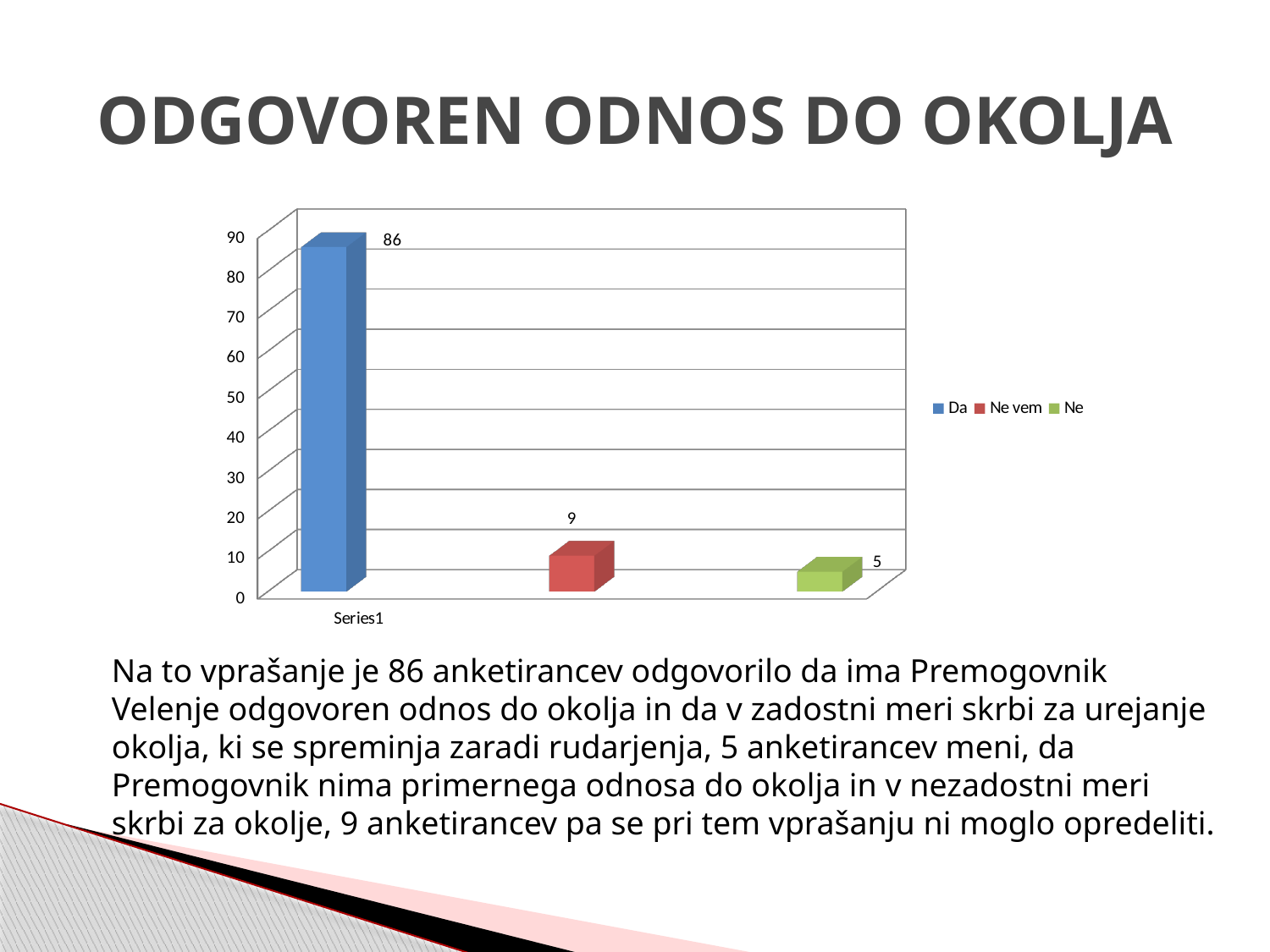
How many series does the legend list? 3 What is the value for "Da"? 86 What is the difference between the values for "Ne vem" and "Ne"? 4 Which legend entry has the highest value? Da Which legend entry has the lowest value? Ne What colour is the bar for "Ne"? green What kind of chart is shown on the slide? bar chart What is the value for "Ne"? 5 Which is larger, the value for "Ne vem" or the value for "Ne"? Ne vem What is the value for "Ne vem"? 9 What is the difference between the values for "Da" and "Ne vem"? 77 Is the value for "Da" greater or less than 80? greater